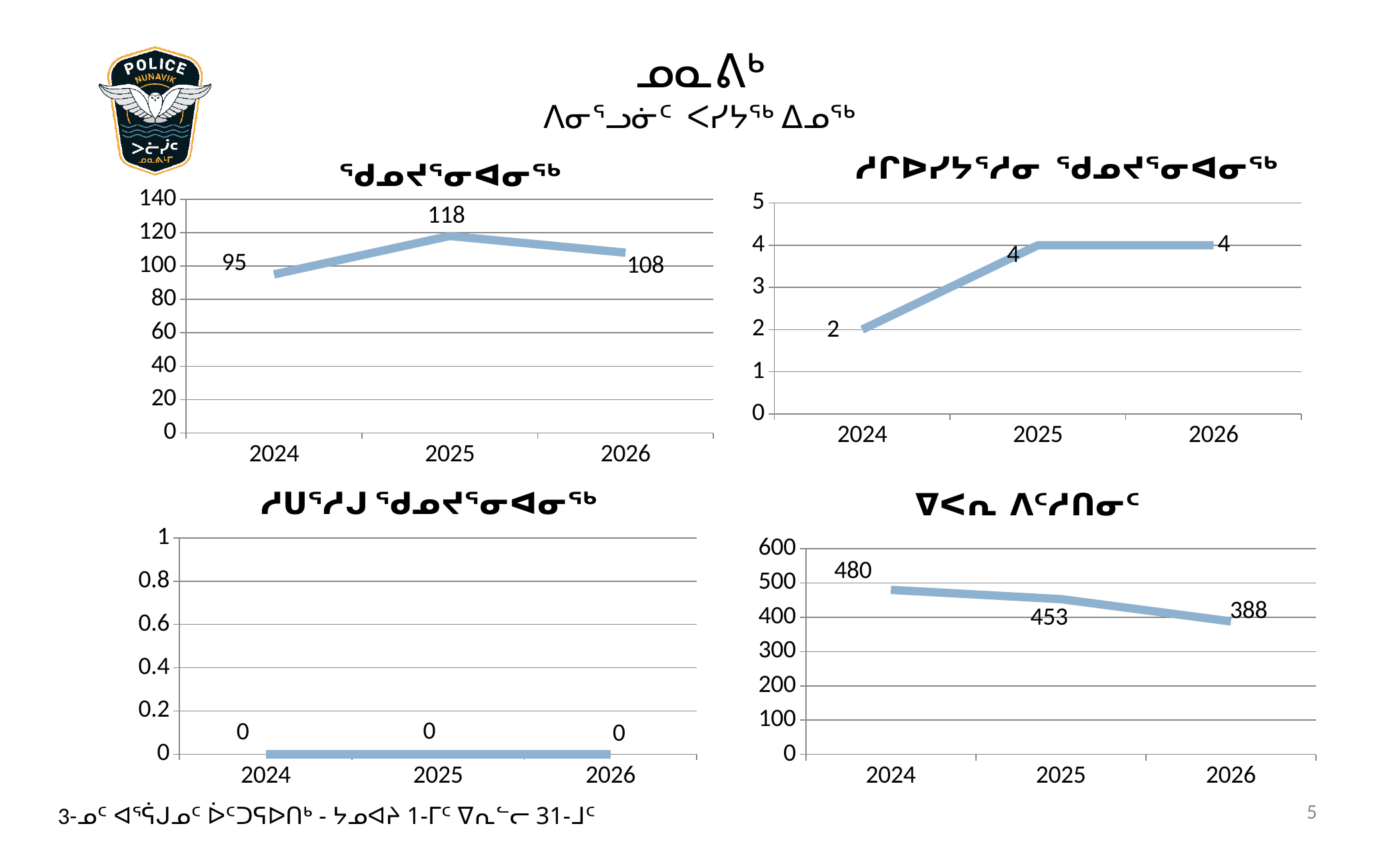
In the top-right chart, is the value for 2025 larger or smaller than the value for 2024? larger In the bottom-right chart, what is the difference between the 2024 and 2026 values? 92 In the top-right chart, how many years are plotted on the x axis? 3 In the top-right chart, what is the value for 2024? 2 In the top-left chart, what is the difference between the 2025 and 2026 values? 10 What kind of chart is the bottom-right chart? line chart In the bottom-right chart, what is the value for 2024? 480 In the bottom-right chart, do the values rise or fall from 2024 to 2026? fall In the top-left chart, which year has the lowest value? 2024 In the top-left chart, what is the value for 2025? 118 In the bottom-left chart, what is the value for 2026? 0 In the bottom-left chart, what is the total of the three plotted values? 0